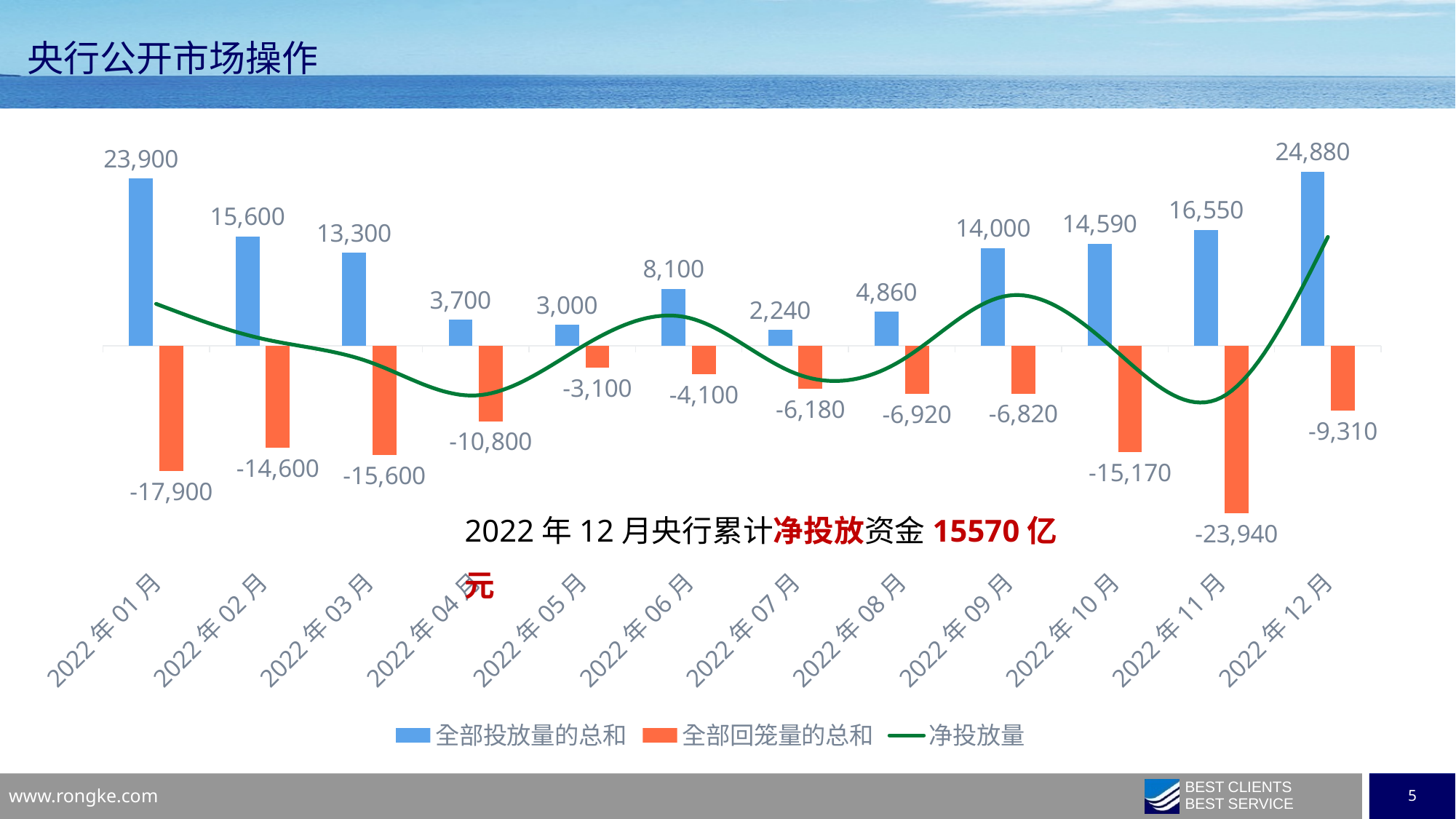
What is the value of 全部回笼量的总和 for 2022 年 11 月? -23,940 What is the value of 全部回笼量的总和 for 2022 年 05 月? -3,100 What is the value of 全部投放量的总和 for 2022 年 01 月? 23,900 How many series does the legend list? 3 What is the value of 全部投放量的总和 for 2022 年 07 月? 2,240 How many months are shown on the x axis? 12 Which month has the lowest 全部投放量的总和? 2022 年 07 月 What is the difference between 全部投放量的总和 in 2022 年 12 月 and 2022 年 01 月? 980 Which month has the highest 全部投放量的总和? 2022 年 12 月 What type of chart is shown on the slide? Combined bar and line chart Which month has the largest 全部回笼量的总和 in absolute terms (the longest orange bar)? 2022 年 11 月 Which is larger, 全部投放量的总和 in 2022 年 09 月 or in 2022 年 10 月? 2022 年 10 月